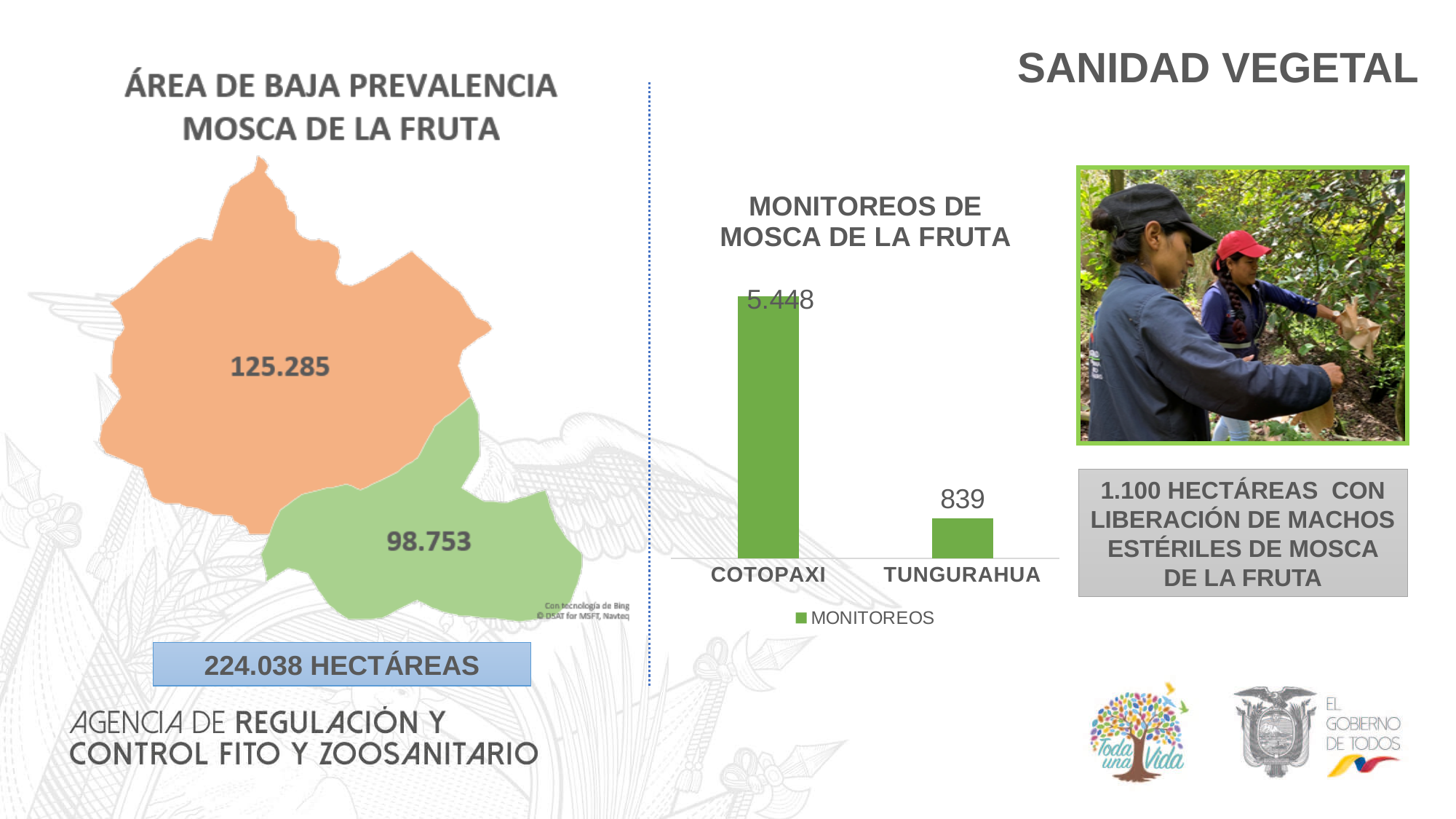
What is the value for TUNGURAHUA in the MONITOREOS DE MOSCA DE LA FRUTA chart? 839 How many categories are shown in the MONITOREOS DE MOSCA DE LA FRUTA chart? 2 What is the title of the bar chart on the slide? MONITOREOS DE MOSCA DE LA FRUTA Do the values in the MONITOREOS DE MOSCA DE LA FRUTA chart rise or fall from COTOPAXI to TUNGURAHUA? fall Which category has the highest value in the MONITOREOS DE MOSCA DE LA FRUTA chart? COTOPAXI What is the value for COTOPAXI in the MONITOREOS DE MOSCA DE LA FRUTA chart? 5.448 Which category has the lowest value in the MONITOREOS DE MOSCA DE LA FRUTA chart? TUNGURAHUA In the MONITOREOS DE MOSCA DE LA FRUTA chart, which is larger: COTOPAXI or TUNGURAHUA? COTOPAXI How many series does the legend of the MONITOREOS DE MOSCA DE LA FRUTA chart list? 1 What series name appears in the legend of the MONITOREOS DE MOSCA DE LA FRUTA chart? MONITOREOS What is the difference between the values for COTOPAXI and TUNGURAHUA in the MONITOREOS DE MOSCA DE LA FRUTA chart? 4.609 What kind of chart is the MONITOREOS DE MOSCA DE LA FRUTA chart? bar chart